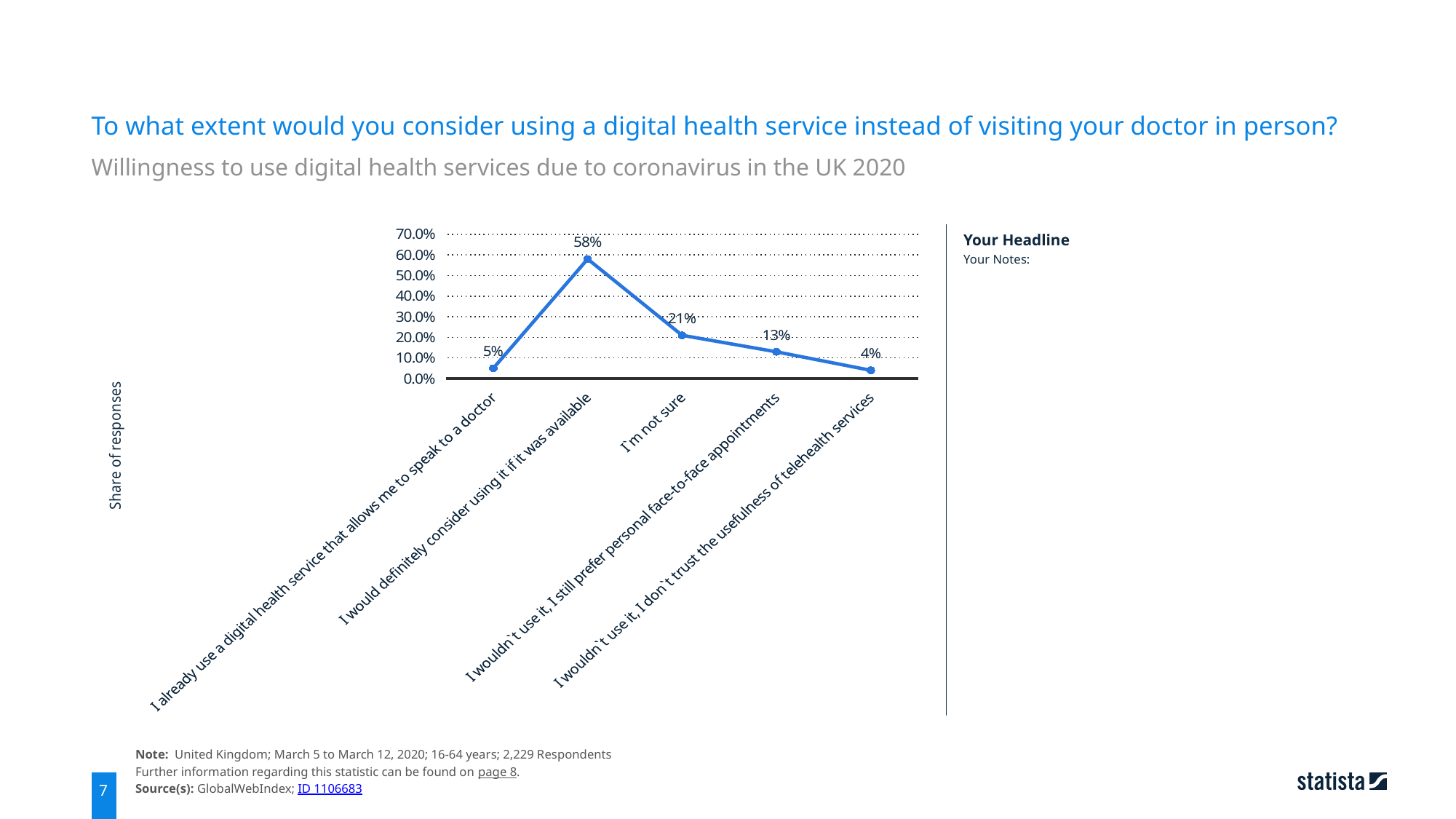
What share of respondents said they already use a digital health service that allows them to speak to a doctor? 5% What is the label of the vertical axis? Share of responses What share of respondents said they wouldn't use it because they don't trust the usefulness of telehealth services? 4% How many response categories are plotted on the chart? 5 Which response category has the highest share? I would definitely consider using it if it was available What is the difference in share between 'I would definitely consider using it if it was available' and 'I'm not sure'? 37% Which response category has the lowest share? I wouldn't use it, I don't trust the usefulness of telehealth services What share of respondents answered 'I'm not sure'? 21% Which is larger: the share for 'I'm not sure' or the share for 'I wouldn't use it, I still prefer personal face-to-face appointments'? I'm not sure What share of respondents said they would definitely consider using a digital health service if it was available? 58% Is the value for 'I would definitely consider using it if it was available' greater or less than 50.0%? greater What type of chart is shown on the slide? Line chart